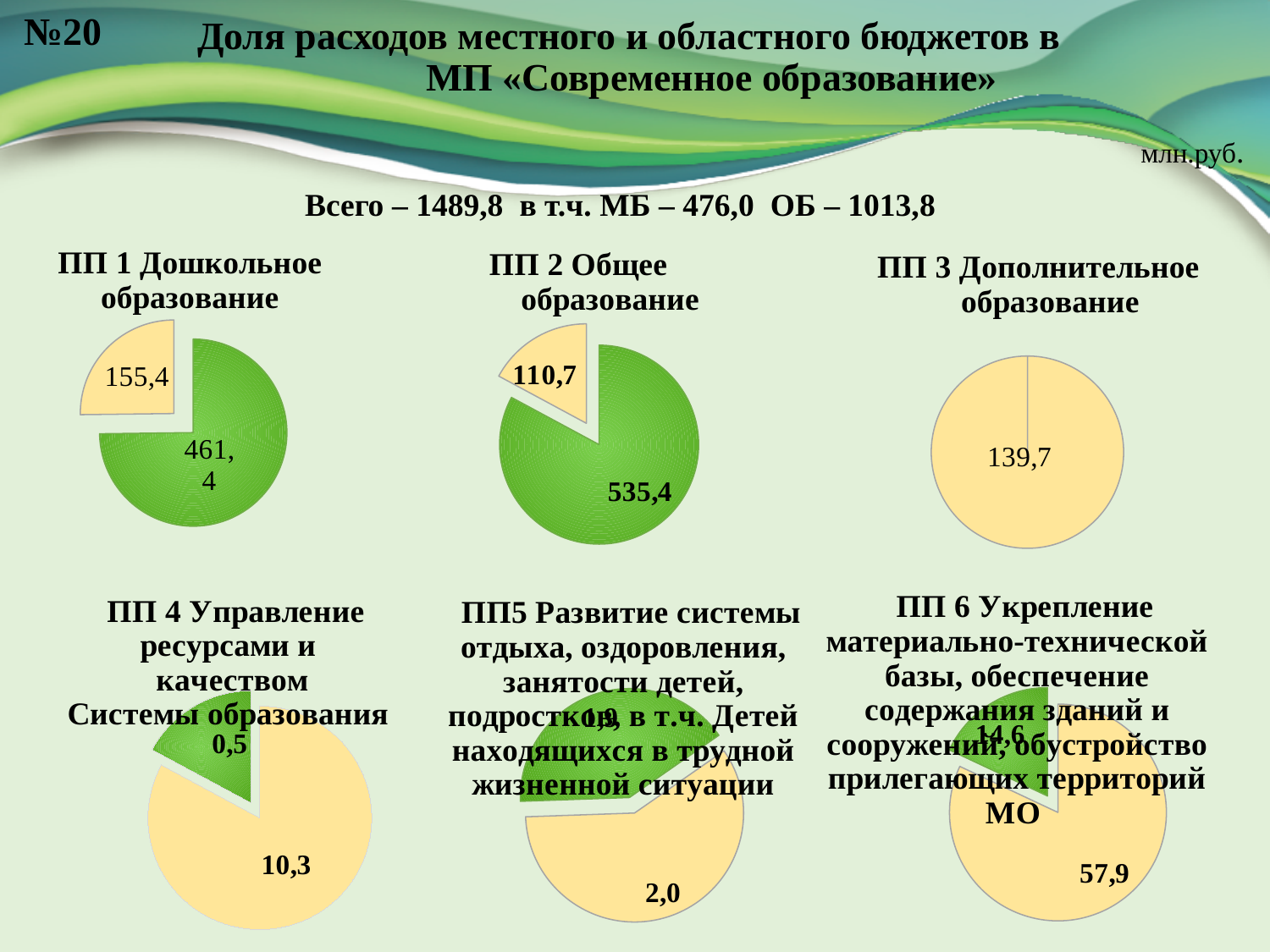
In the pie chart 'ПП 1 Дошкольное образование', what is the difference between the green slice and the yellow slice? 306,0 What type of charts are shown on the slide? Pie charts In the pie chart 'ПП 6 Укрепление материально-технической базы...', what is the value of the larger (yellow) slice? 57,9 In the pie chart 'ПП 4 Управление ресурсами и качеством Системы образования', what is the value of the smaller (green) slice? 0,5 In the pie chart 'ПП 2 Общее образование', what is the value of the larger (green) slice? 535,4 In the pie chart 'ПП 2 Общее образование', what is the difference between the green slice and the yellow slice? 424,7 How many pie charts are shown on the slide? 6 In the pie chart 'ПП 1 Дошкольное образование', what is the value of the smaller (yellow) slice? 155,4 In the pie chart 'ПП 1 Дошкольное образование', what is the value of the larger (green) slice? 461,4 What value is shown in the pie chart 'ПП 3 Дополнительное образование'? 139,7 In the pie chart 'ПП 2 Общее образование', what is the value of the smaller (yellow) slice? 110,7 In the pie chart 'ПП 4 Управление ресурсами и качеством Системы образования', what is the value of the larger (yellow) slice? 10,3